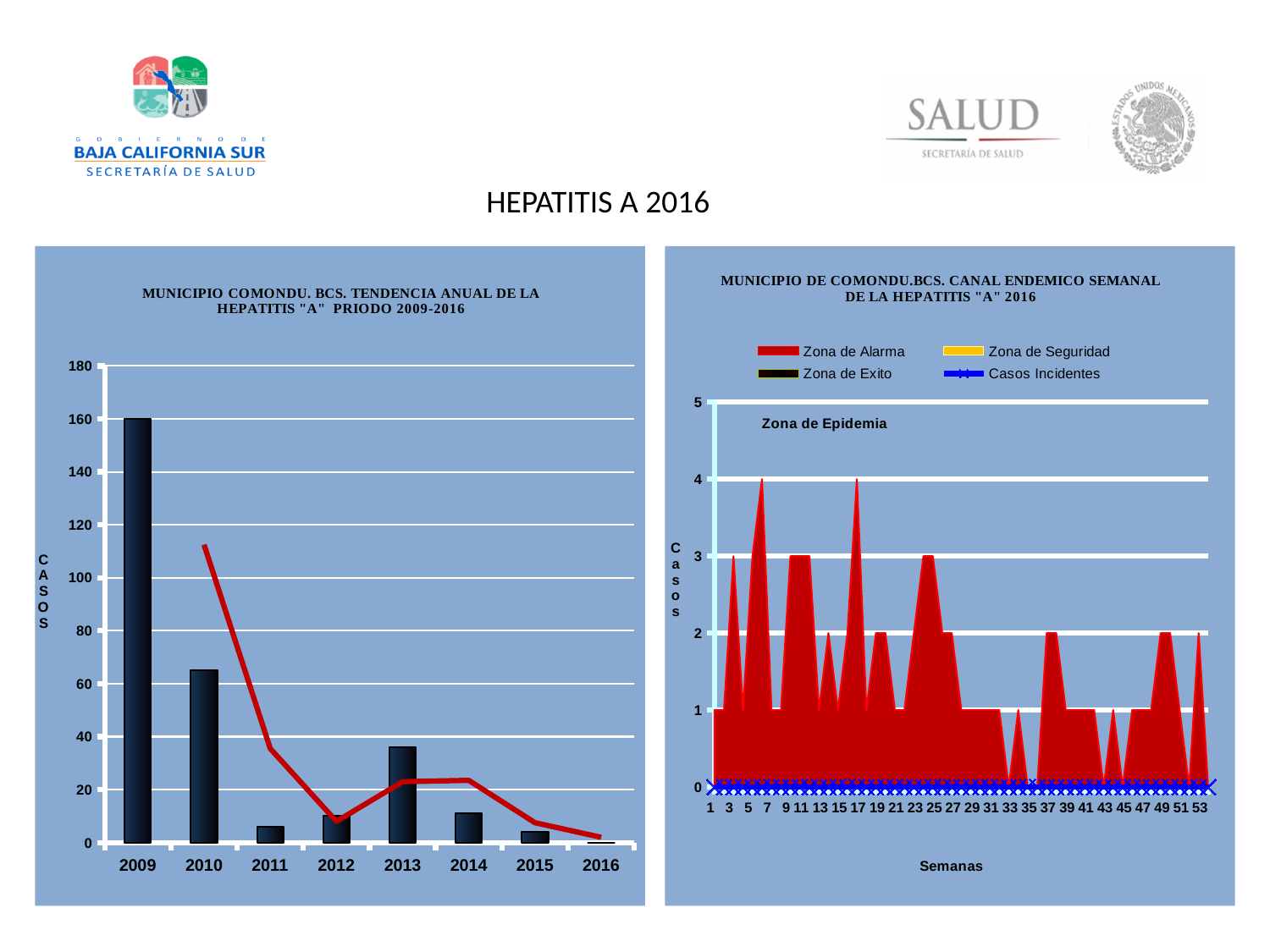
In the right chart (CANAL ENDEMICO SEMANAL DE LA HEPATITIS "A" 2016), what is the highest value reached by the Zona de Alarma area? 4 In the left chart (TENDENCIA ANUAL DE LA HEPATITIS "A"), which year has more cases, 2013 or 2014? 2013 In the left chart (TENDENCIA ANUAL DE LA HEPATITIS "A"), which year has the lowest number of cases? 2016 In the left chart (MUNICIPIO COMONDU. BCS. TENDENCIA ANUAL DE LA HEPATITIS "A" PRIODO 2009-2016), what kind of chart is used to show the yearly cases? bar chart In the right chart (CANAL ENDEMICO SEMANAL DE LA HEPATITIS "A" 2016), how many series does the legend list? 4 In the right chart (CANAL ENDEMICO SEMANAL DE LA HEPATITIS "A" 2016), what text label appears inside the plot area near the top? Zona de Epidemia In the left chart (TENDENCIA ANUAL DE LA HEPATITIS "A"), is the value for 2009 greater or less than 140? greater In the left chart (TENDENCIA ANUAL DE LA HEPATITIS "A"), do the cases generally rise or fall from 2009 to 2016? fall In the left chart (TENDENCIA ANUAL DE LA HEPATITIS "A"), which year has the highest number of cases? 2009 In the left chart (TENDENCIA ANUAL DE LA HEPATITIS "A"), how many years are shown on the x axis? 8 In the right chart (CANAL ENDEMICO SEMANAL DE LA HEPATITIS "A" 2016), what is the label of the x axis? Semanas In the left chart (TENDENCIA ANUAL DE LA HEPATITIS "A"), is the value for 2010 greater or less than 80? less